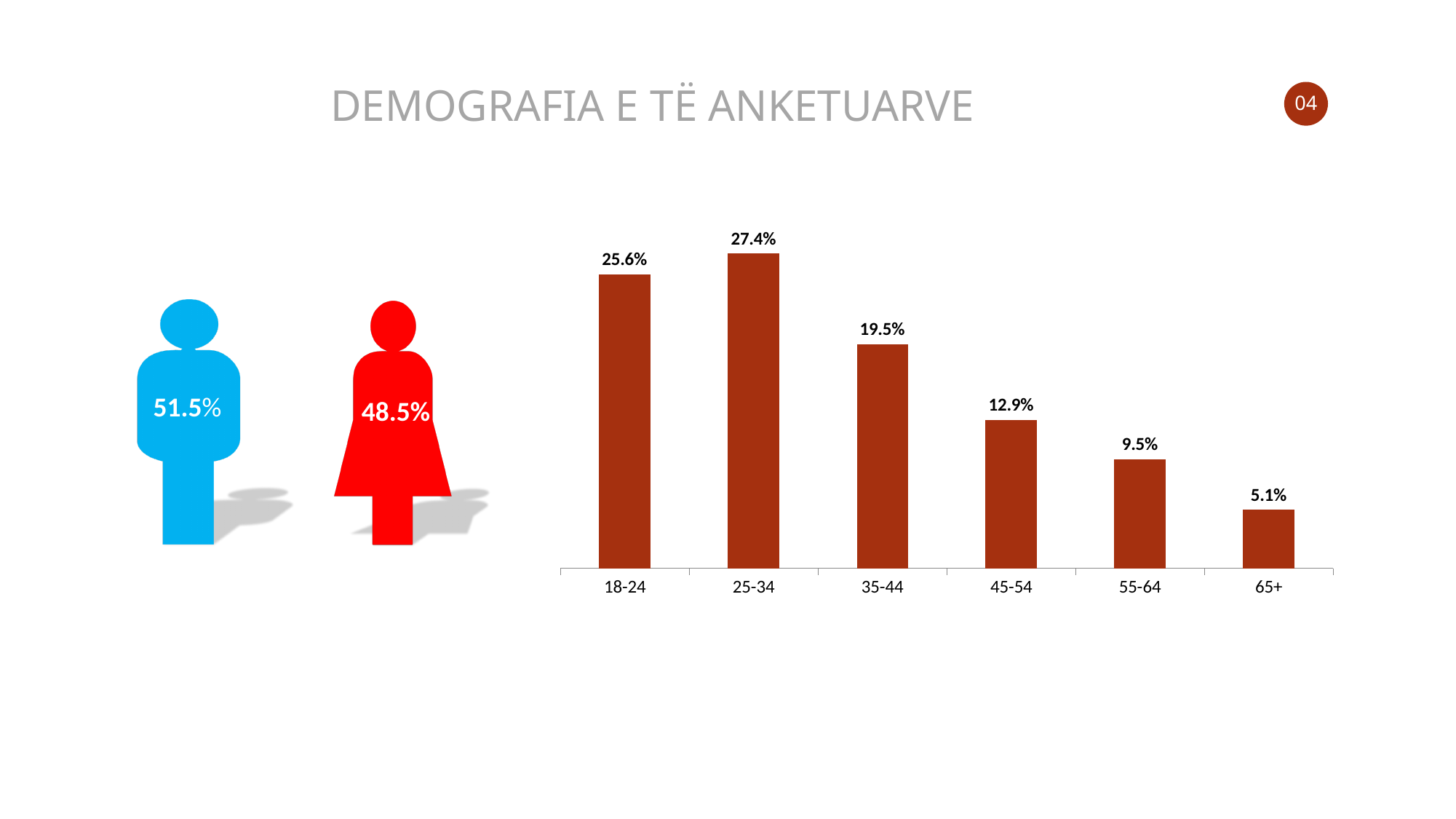
Do the values rise or fall from 25-34 to 65+ along the x axis? fall What is the title of the slide? DEMOGRAFIA E TË ANKETUARVE What kind of chart shows the age groups? bar chart What is the value for the 18-24 age group? 25.6% What is the difference between the values for 45-54 and 55-64? 3.4% Which age group has the lowest value? 65+ Which age group has the highest value? 25-34 What is the value for the 65+ age group? 5.1% How many age groups are shown on the bar chart? 6 What is the value for the 35-44 age group? 19.5% What is the difference between the values for 25-34 and 18-24? 1.8% Which is larger, the value for 35-44 or the value for 45-54? 35-44